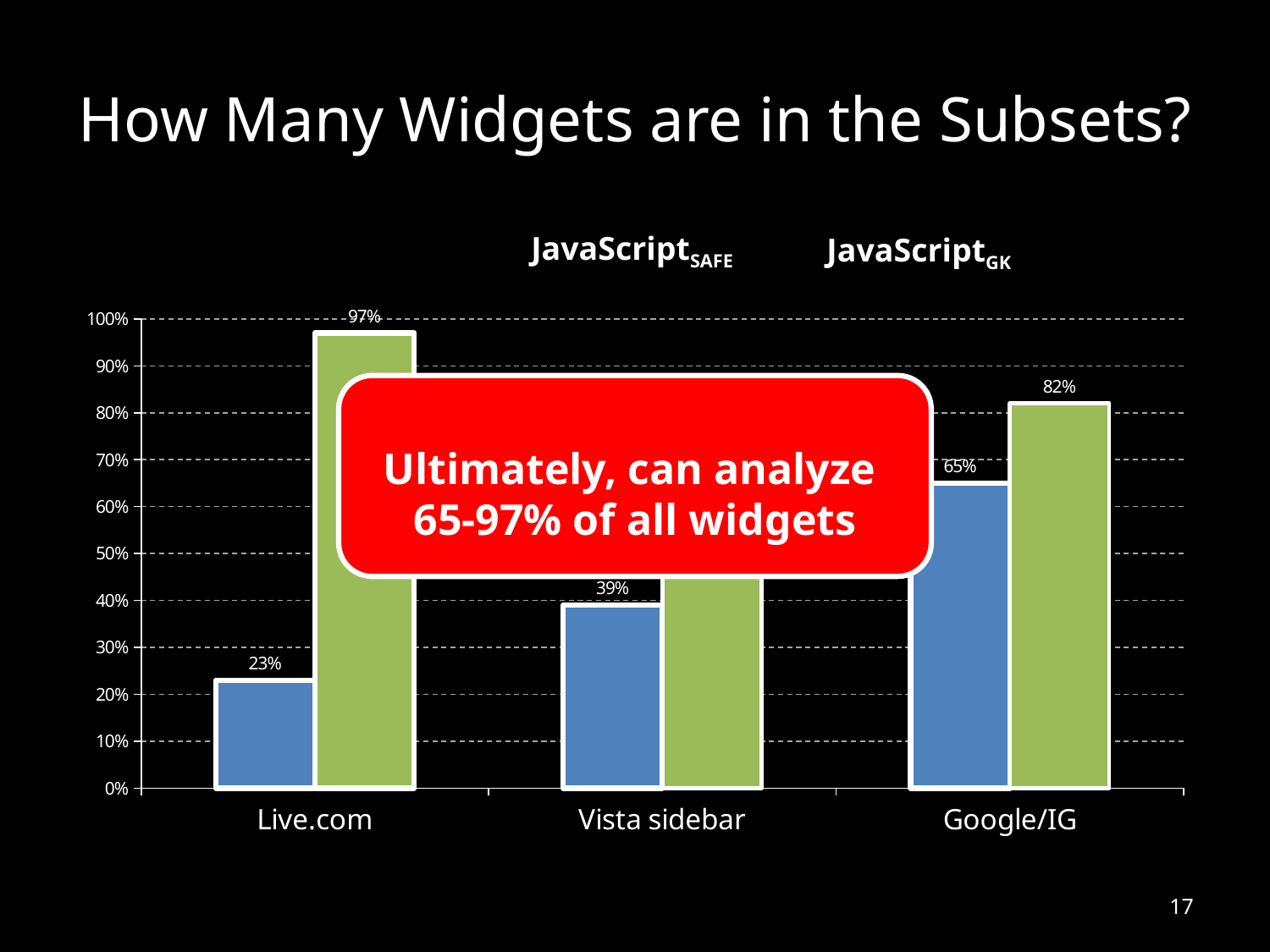
Is the JavaScript_GK value for Vista sidebar greater or less than 40%? less What is the JavaScript_GK value for Google/IG? 65% Which category has the highest JavaScript_GK value? Google/IG What is the JavaScript_SAFE value for Live.com? 97% What kind of chart is shown on the slide? Bar chart What is the JavaScript_GK value for Live.com? 23% What is the difference between the JavaScript_GK and JavaScript_SAFE values for Live.com? 74 percentage points How many series does the legend list? 2 How many categories are shown on the x axis? 3